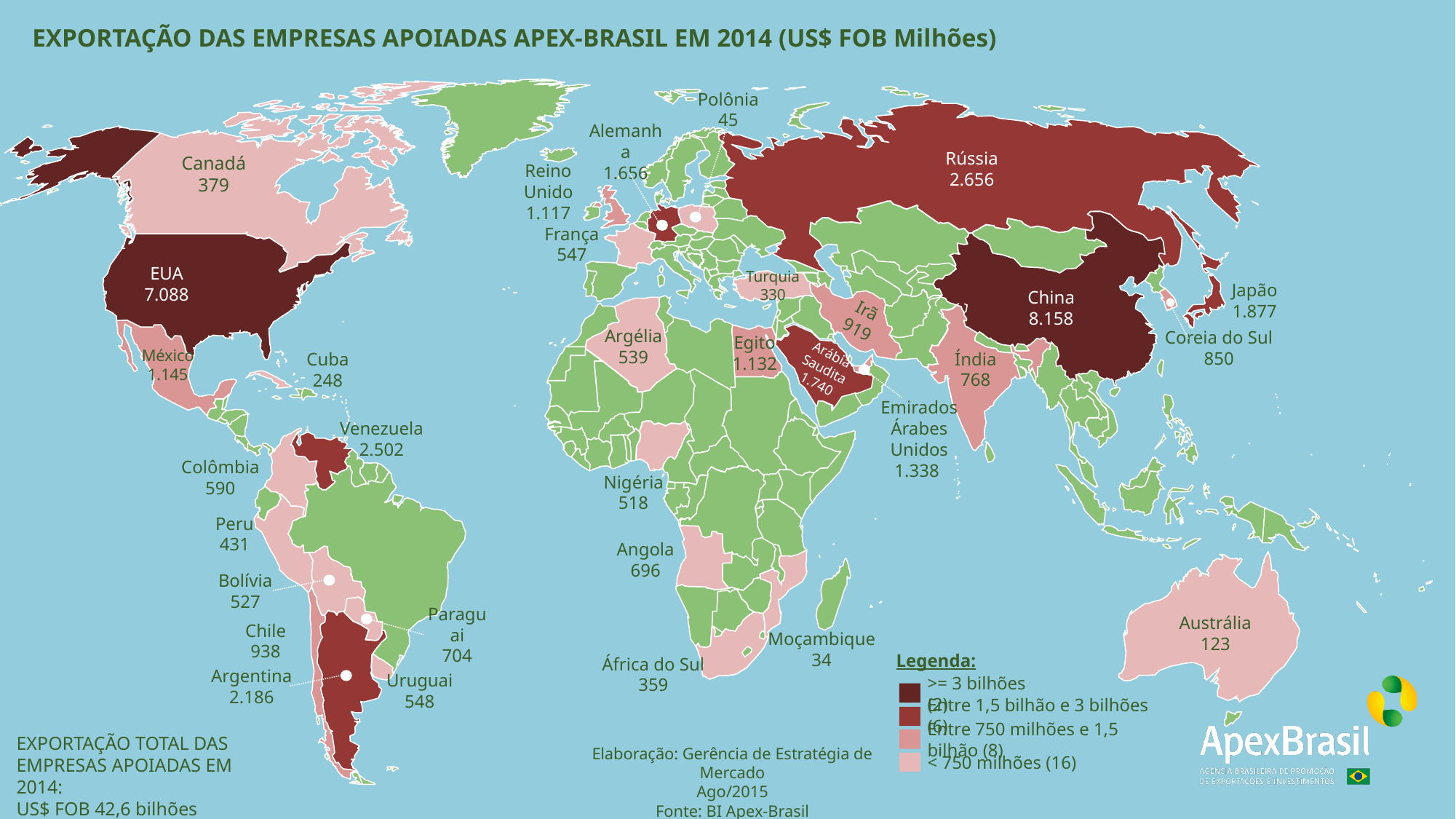
What is the export value shown for China? 8.158 What is the export value shown for EUA? 7.088 What is the title of the chart? EXPORTAÇÃO DAS EMPRESAS APOIADAS APEX-BRASIL EM 2014 (US$ FOB Milhões) What kind of chart is shown on the slide? Map chart Which has a larger export value, Japão or Alemanha? Japão Which country has the highest export value on the map? China How many categories does the legend list? 4 What is the export value shown for Argentina? 2.186 What is the difference between the export values of China and EUA? 1.070 Which has a larger export value, Rússia or Venezuela? Rússia Which country has the lowest export value on the map? Moçambique What is the export value shown for Moçambique? 34